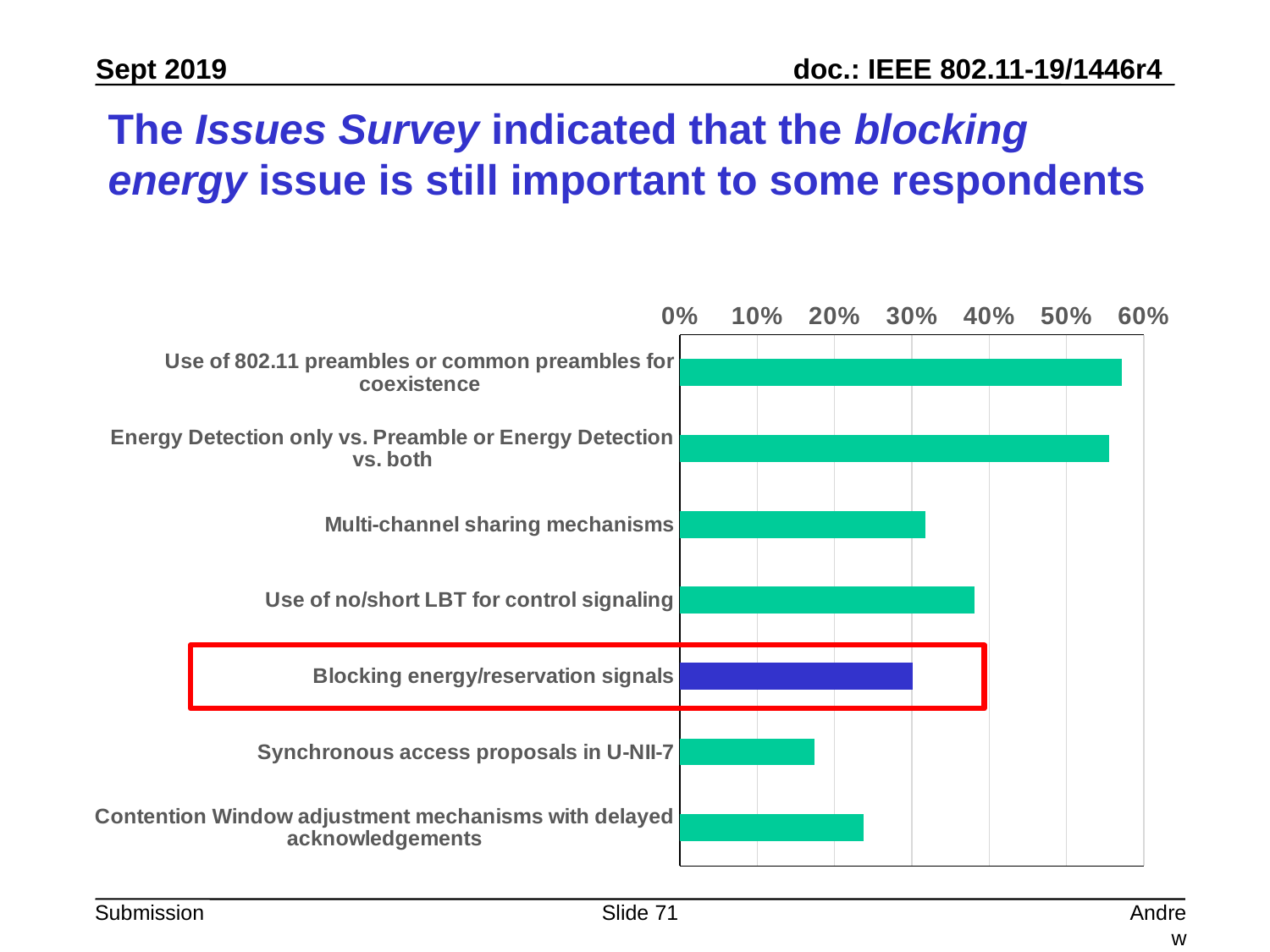
Is the value for Blocking energy/reservation signals greater or less than 40%? less Which category's bar is coloured blue and outlined with a red box? Blocking energy/reservation signals How many categories are plotted in the chart? 7 Is the value for Use of no/short LBT for control signaling greater or less than 30%? greater Is the value for Energy Detection only vs. Preamble or Energy Detection vs. both greater or less than 50%? greater Which has a larger value: Contention Window adjustment mechanisms with delayed acknowledgements or Synchronous access proposals in U-NII-7? Contention Window adjustment mechanisms with delayed acknowledgements What kind of chart is shown on the slide? bar chart Which has a larger value: Use of no/short LBT for control signaling or Multi-channel sharing mechanisms? Use of no/short LBT for control signaling Which category has the lowest value in the chart? Synchronous access proposals in U-NII-7